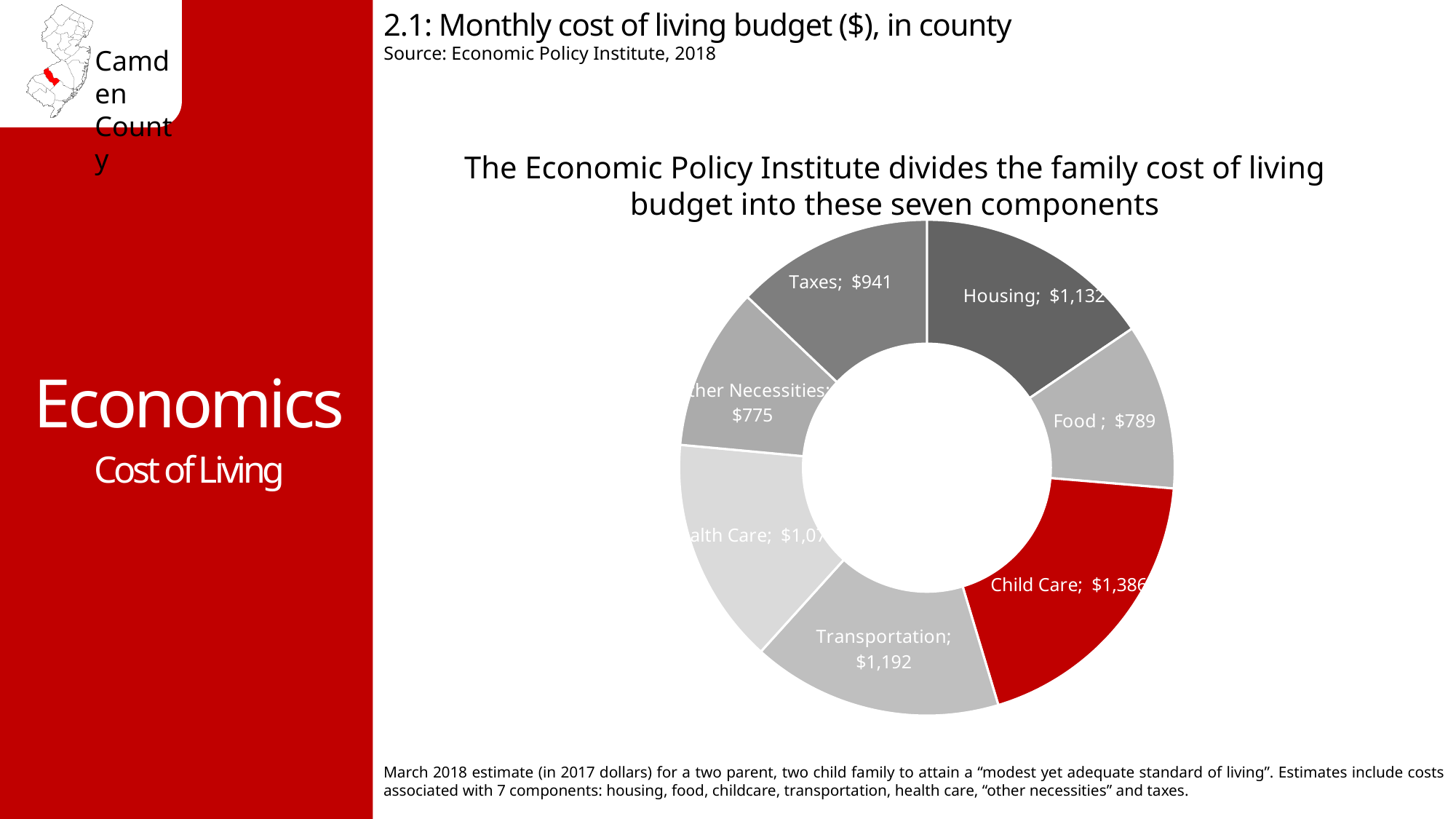
What is the difference between the Child Care and Housing monthly costs? $254 What kind of chart is shown on the slide? Doughnut (pie) chart What is the monthly cost for Other Necessities in the chart? $775 Which component has the highest monthly cost in the chart? Child Care What is the monthly cost for Taxes in the chart? $941 What is the monthly cost for Transportation in the chart? $1,192 Which component has the lowest monthly cost in the chart? Other Necessities What is the monthly cost for Food in the chart? $789 What is the monthly cost for Housing in the chart? $1,132 How many components are shown in the chart? 7 Which is larger, the monthly cost for Transportation or for Taxes? Transportation What is the monthly cost for Child Care in the chart? $1,386